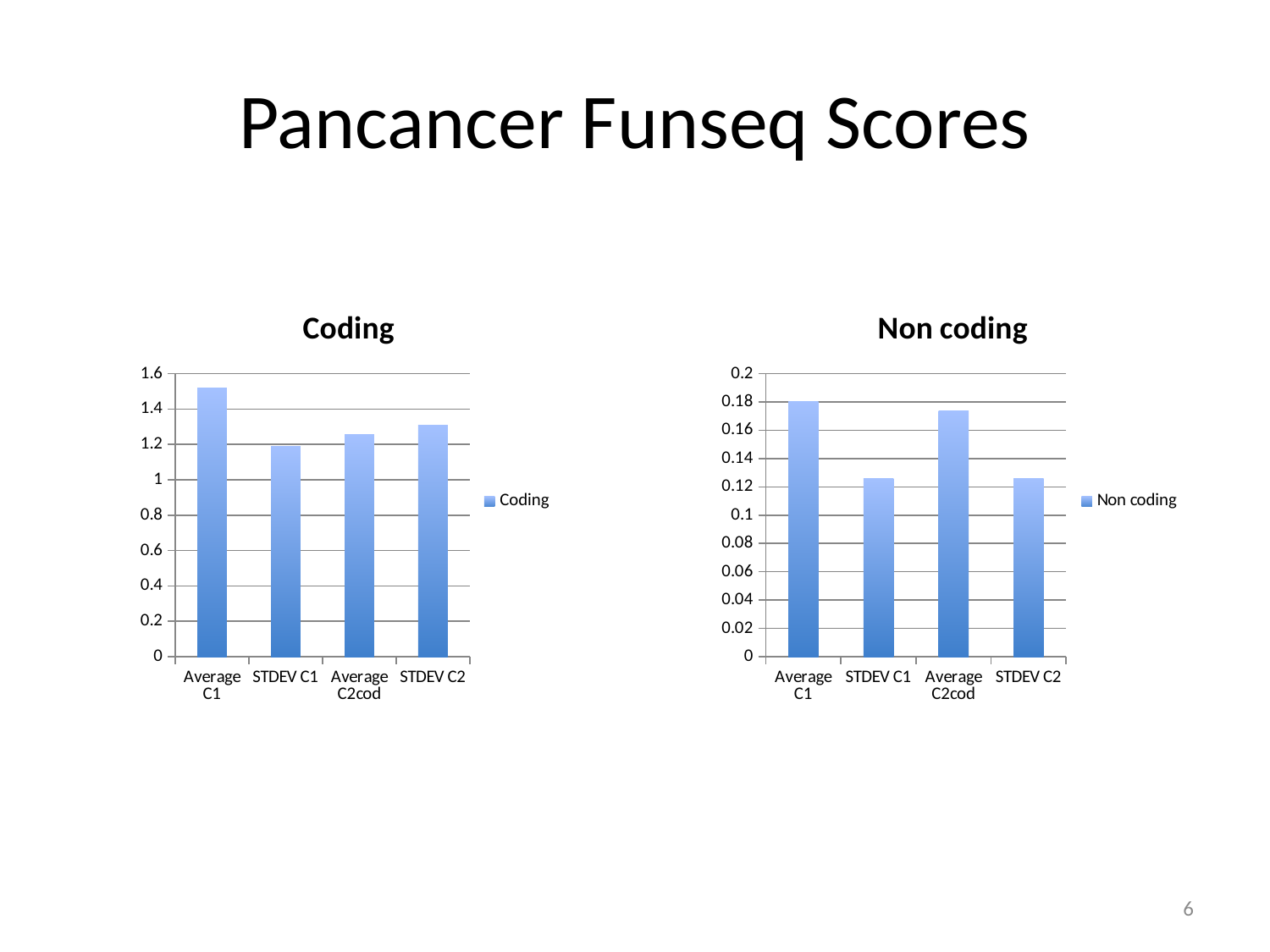
In the Coding chart, is the value for STDEV C2 greater or less than 1.4? less In the Non coding chart, which category has the highest value? Average C1 In the Coding chart, which category has the lowest value? STDEV C1 In the Non coding chart, which is larger, Average C2cod or STDEV C2? Average C2cod In the Non coding chart, is the value for Average C2cod greater or less than 0.16? greater What kind of chart is the Coding chart? Bar chart How many categories are shown in the Non coding chart? 4 In the Non coding chart, is the value for STDEV C1 greater or less than 0.14? less In the Coding chart, which is larger, Average C1 or STDEV C1? Average C1 In the Coding chart, which category has the highest value? Average C1